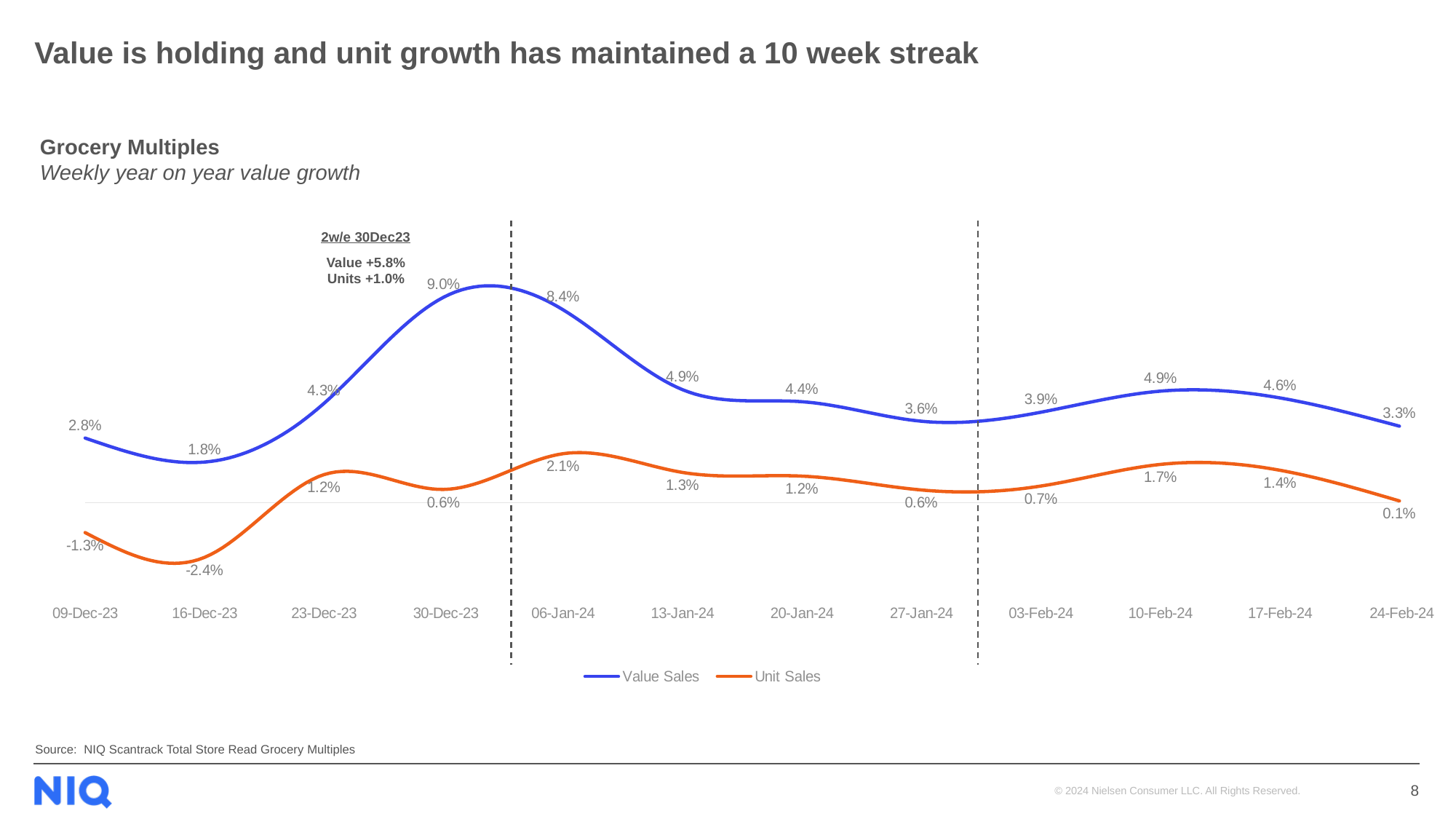
What is the Value Sales growth for 30-Dec-23? 9.0% Which is larger, the Value Sales growth for 13-Jan-24 or for 20-Jan-24? 13-Jan-24 How many series does the legend list? 2 Which week has the lowest Unit Sales growth? 16-Dec-23 Which week has the highest Value Sales growth? 30-Dec-23 What is the Value Sales growth for 27-Jan-24? 3.6% What is the Unit Sales growth for 24-Feb-24? 0.1% What is the difference between Value Sales and Unit Sales growth for 06-Jan-24? 6.3% What kind of chart is shown on the slide? Line chart What is the Unit Sales growth for 16-Dec-23? -2.4% Does Value Sales growth rise or fall from 10-Feb-24 to 24-Feb-24? Fall How many weeks are plotted on the x axis? 12